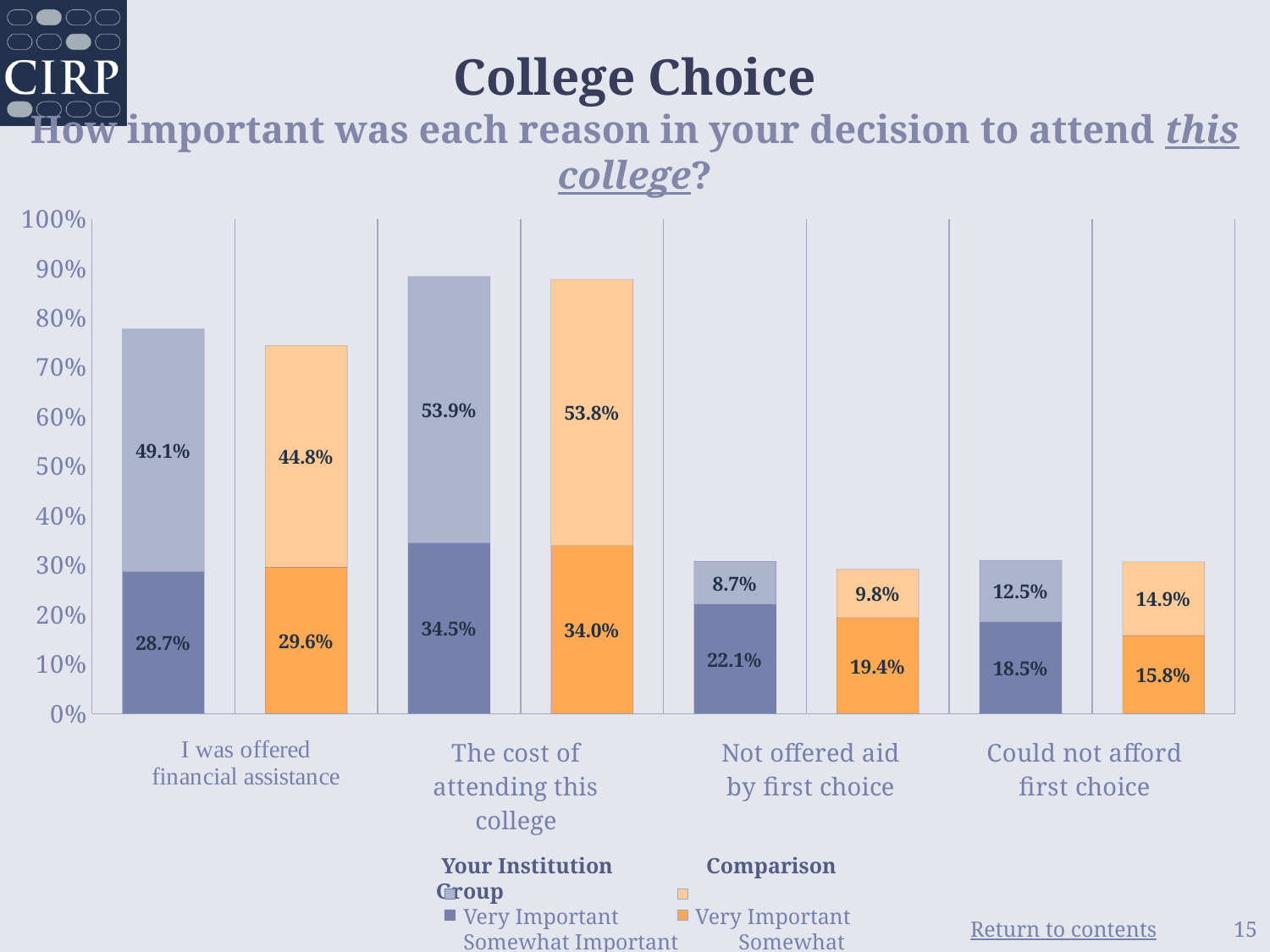
What percentage of Your Institution respondents rated "The cost of attending this college" as Very Important? 34.5% Which reason has the lowest Somewhat Important percentage for Your Institution? Not offered aid by first choice What is the total height of the Comparison Group stacked bar for "The cost of attending this college"? 87.8% For "Could not afford first choice", which group has the larger Somewhat Important value, Your Institution or the Comparison Group? Comparison Group Which reason has the highest Very Important percentage for Your Institution? The cost of attending this college What percentage of the Comparison Group rated "I was offered financial assistance" as Somewhat Important? 44.8% What is the Very Important value for the Comparison Group on "Could not afford first choice"? 15.8% How many reasons (categories) are shown on the x axis? 4 How many series does the legend list? 4 What is the total height of the Your Institution stacked bar for "I was offered financial assistance"? 77.8% What is the difference between the Very Important values for Your Institution and the Comparison Group on "Not offered aid by first choice"? 2.7% What kind of chart is shown on the slide? Stacked bar chart